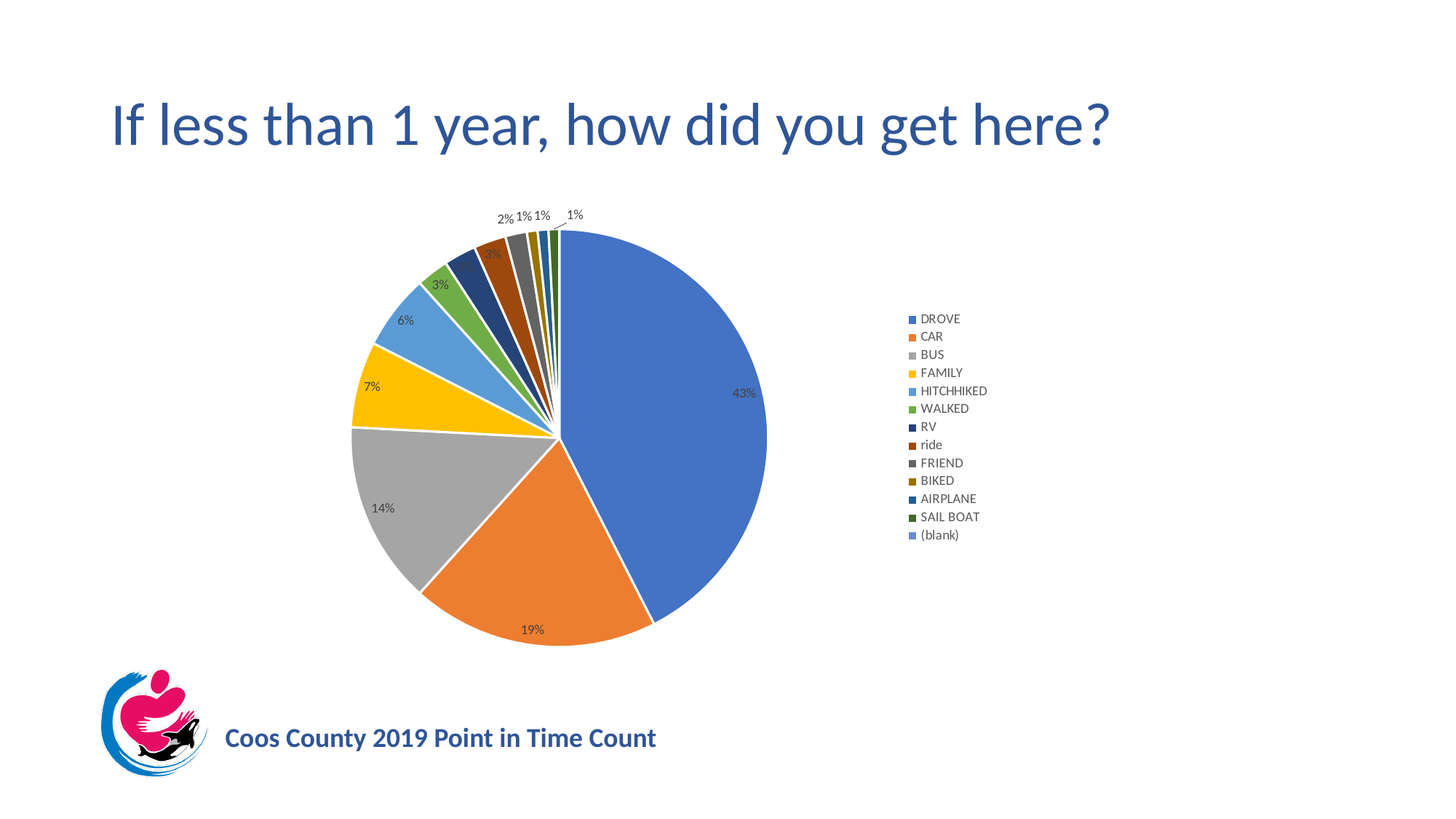
What kind of chart is shown on the slide? Pie chart What percentage is shown for WALKED? 3% What is the title of the slide containing the chart? If less than 1 year, how did you get here? How many entries does the legend list? 13 What percentage is shown for HITCHHIKED? 6% What percentage is shown for CAR? 19% Which is larger, the share for BUS or the share for FAMILY? BUS Which category has the largest slice of the pie? DROVE What percentage is shown for BUS? 14% What is the difference in percentage points between DROVE and CAR? 24 What share of the pie does DROVE account for? 43% What percentage is shown for FAMILY? 7%